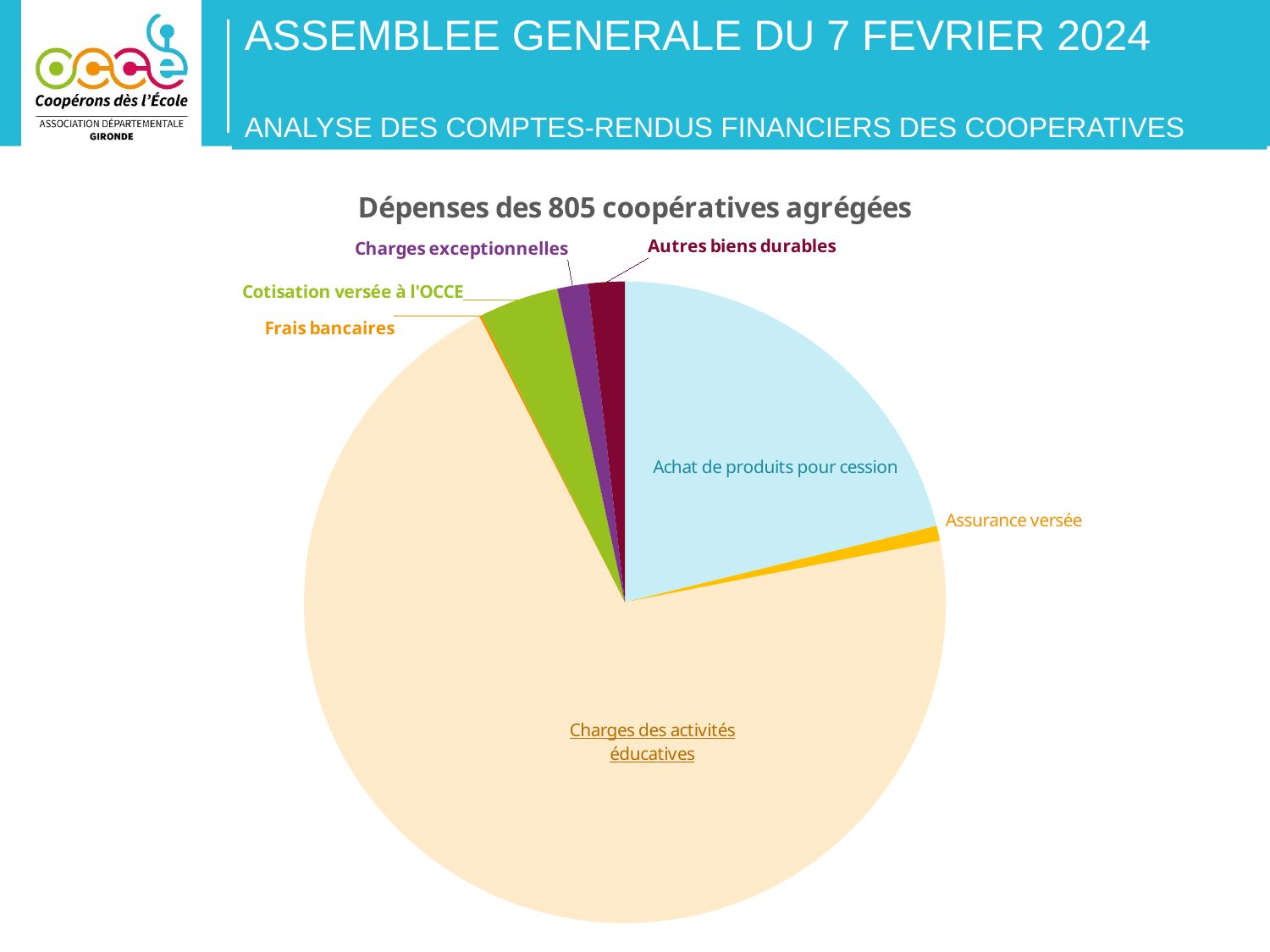
Which slice is larger: Charges des activités éducatives or Achat de produits pour cession? Charges des activités éducatives Which category has the smallest slice of the pie? Frais bancaires Which slice is larger: Cotisation versée à l'OCCE or Assurance versée? Cotisation versée à l'OCCE Which slice is larger: Achat de produits pour cession or Cotisation versée à l'OCCE? Achat de produits pour cession Which category has the largest slice of the pie? Charges des activités éducatives What colour is the slice for Achat de produits pour cession? light blue How many slices (categories) does the pie chart have? 7 What is the title of the chart? Dépenses des 805 coopératives agrégées What kind of chart is shown on the slide? pie chart